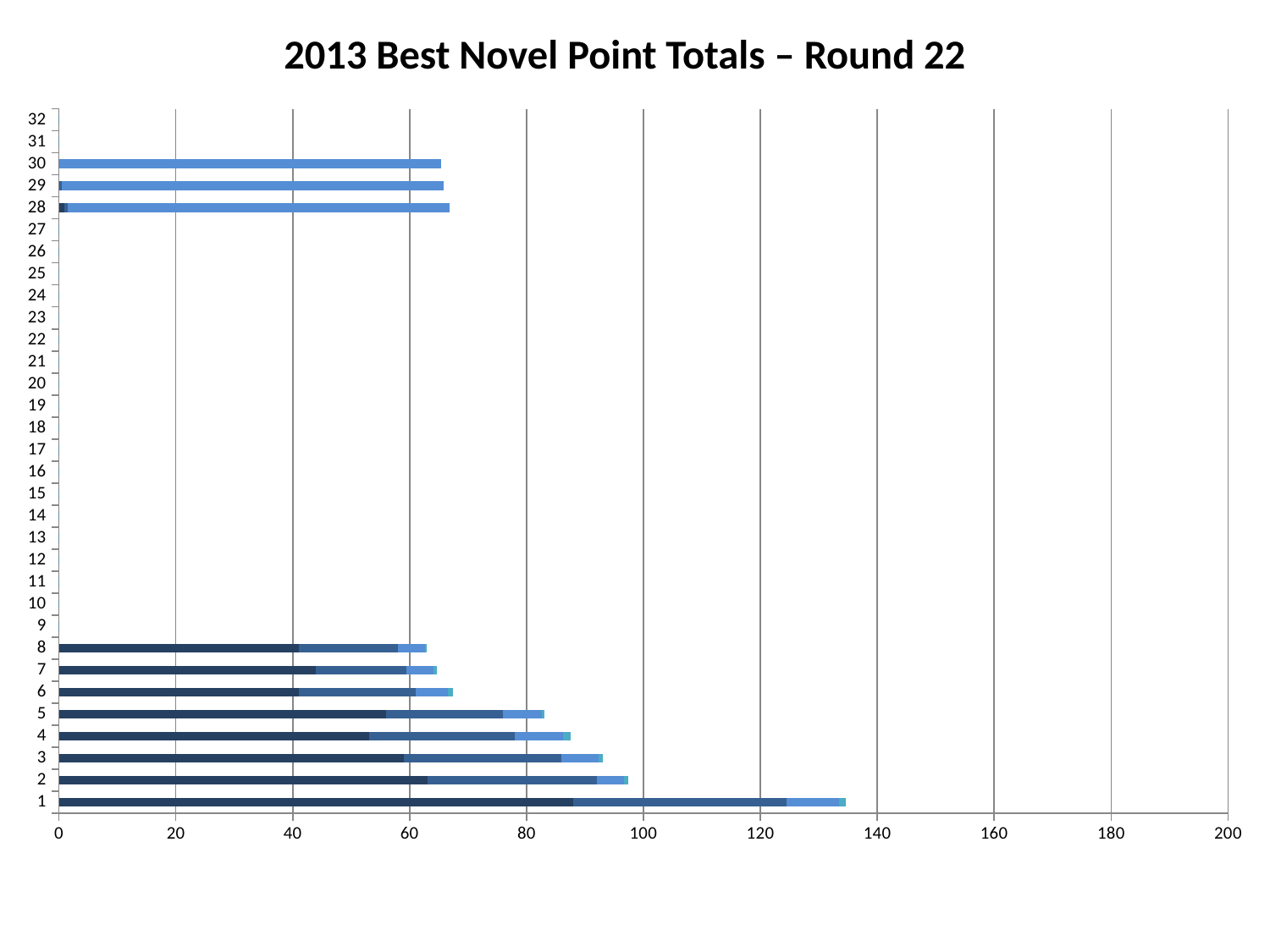
Is the total for category 5 greater or less than 80? greater How many categories are listed on the vertical axis? 32 Which has the larger total, category 1 or category 2? 1 Is the total for category 1 greater or less than 120? greater What kind of chart is shown on the slide? bar chart Which has the larger total, category 5 or category 8? 5 Is the total for category 2 greater or less than 100? less Which category has the highest total on the chart? 1 What is the highest value shown on the horizontal axis? 200 What is the title of the chart? 2013 Best Novel Point Totals – Round 22